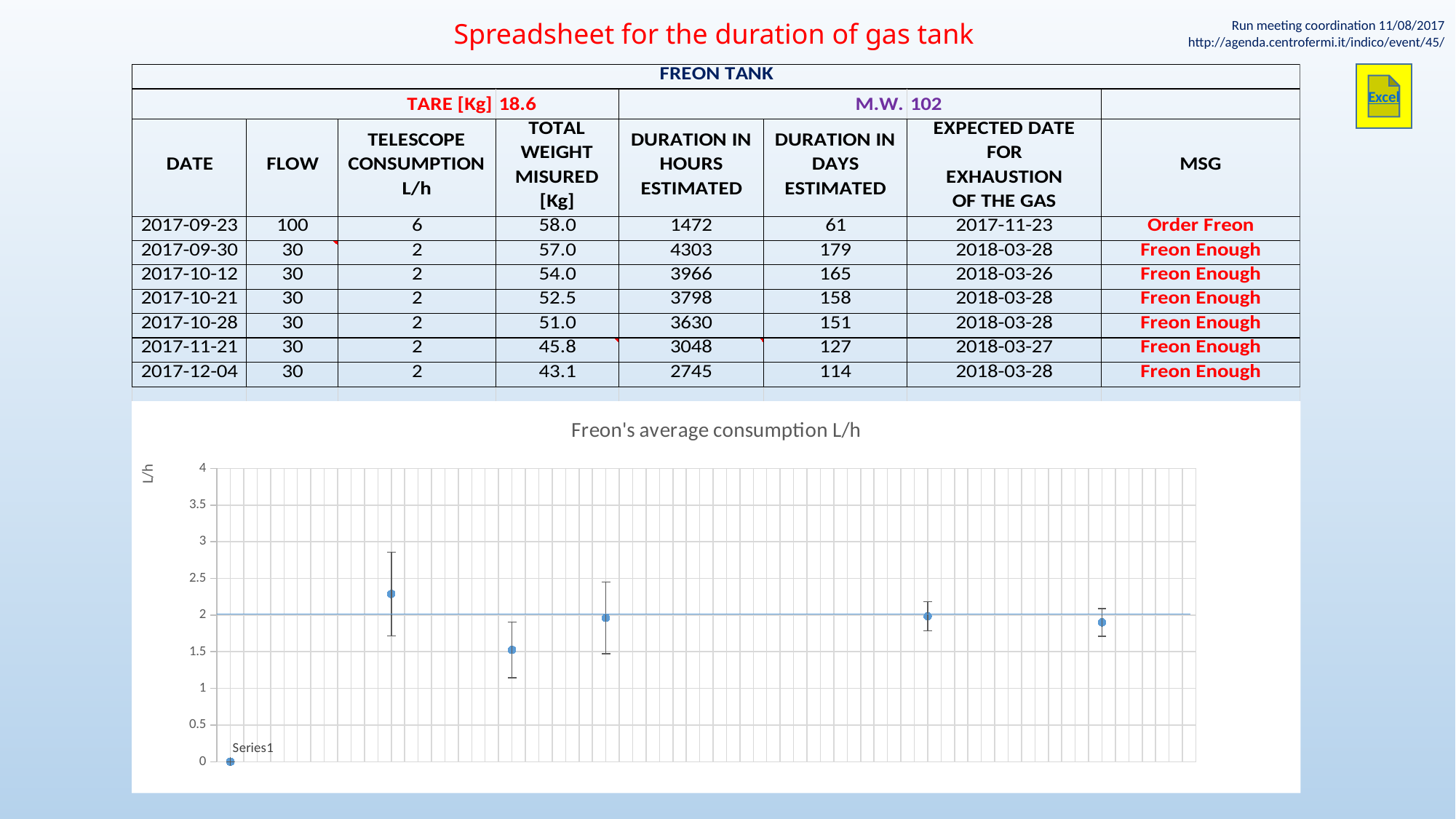
What is the title of the chart on the slide? Freon's average consumption L/h Is the value of the third point from the left on the chart greater or less than 2? less What is the label on the vertical axis of the chart? L/h Among the points plotted above 0, which point on the chart has the lowest value? the third point from the left How many data points on the chart are plotted above 0? 5 Which point on the chart has the highest value: the second from the left or the third from the left? the second from the left Is the value of the third point from the left on the chart greater or less than 1? greater Is the value of the rightmost point on the chart greater or less than 1.5? greater What kind of chart is shown below the table? scatter chart What is the highest value shown on the chart's vertical axis? 4 Among the points plotted above 0, which point on the chart has the highest value? the second point from the left